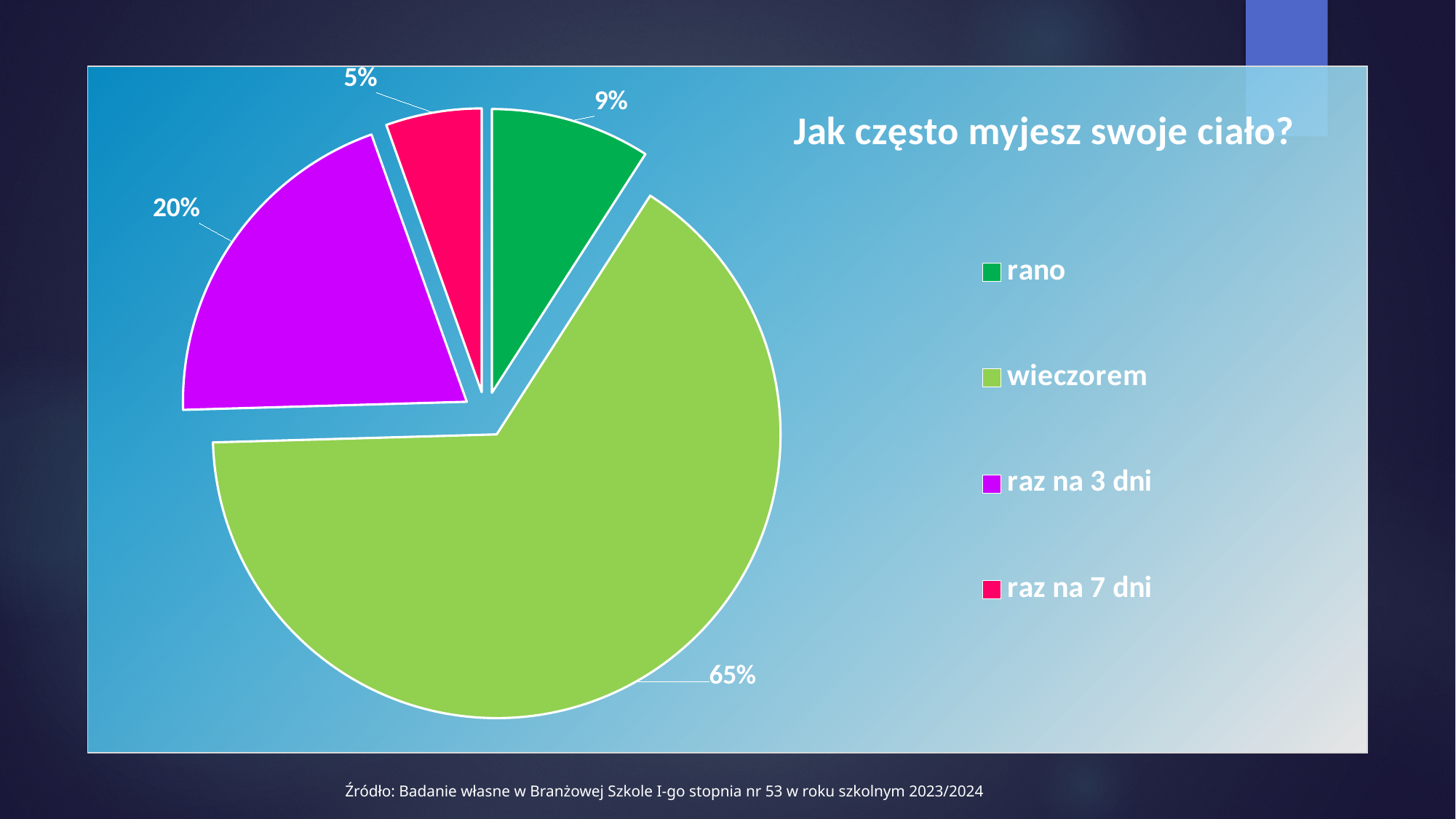
What share of the pie does "rano" have? 9% What kind of chart is shown on the slide? pie chart Which category has the smallest slice of the pie? raz na 7 dni What share of the pie does "raz na 7 dni" have? 5% How many categories does the pie chart show? 4 Which category has the largest slice of the pie? wieczorem What share of the pie does "wieczorem" have? 65% Which is larger, the share for "rano" or the share for "raz na 3 dni"? raz na 3 dni What is the title of the chart? Jak często myjesz swoje ciało? Which colour represents "raz na 3 dni" in the legend? purple What is the difference in percentage points between "wieczorem" and "raz na 3 dni"? 45